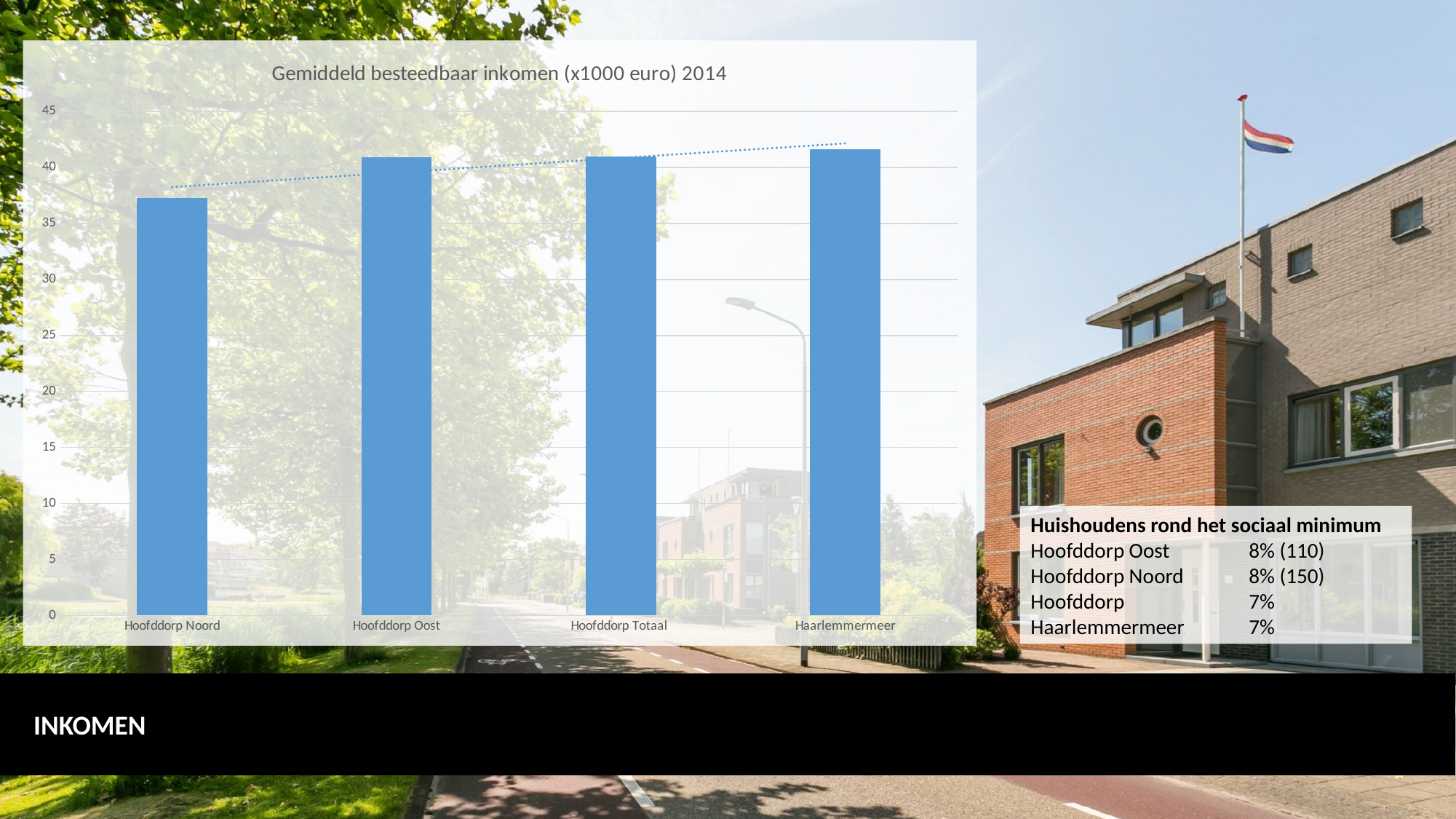
What kind of chart is shown on the slide? bar chart Is the value for Haarlemmermeer greater or less than 40? greater Is the value for Hoofddorp Oost greater or less than 40? greater What is the highest value shown on the vertical axis of the chart? 45 How many categories are shown on the x axis of the chart? 4 Do the values generally rise or fall from left to right along the x axis? rise Which is larger, the value for Hoofddorp Noord or the value for Haarlemmermeer? Haarlemmermeer What is the title of the chart? Gemiddeld besteedbaar inkomen (x1000 euro) 2014 Is the value for Hoofddorp Noord greater or less than 35? greater Which category has the lowest average disposable income in the chart? Hoofddorp Noord Which is larger, the value for Hoofddorp Noord or the value for Hoofddorp Oost? Hoofddorp Oost